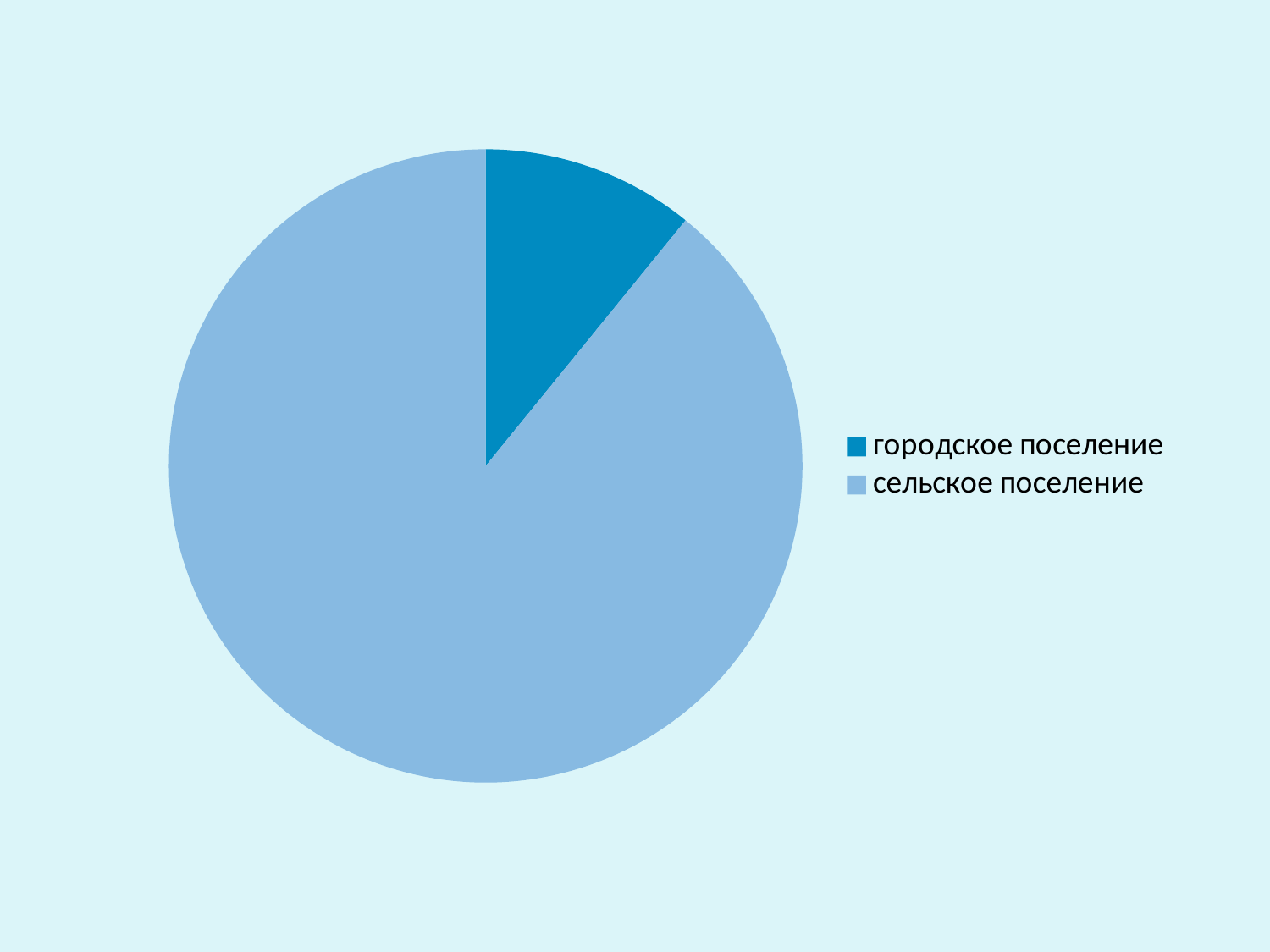
Which category has the largest slice of the pie? сельское поселение Which category is shown in the darker blue colour? городское поселение Which slice is larger: городское поселение or сельское поселение? сельское поселение Which category is shown in the lighter blue colour? сельское поселение What kind of chart is shown on the slide? pie chart How many slices does the pie chart have? 2 Which category has the smallest slice of the pie? городское поселение How many entries does the legend list? 2